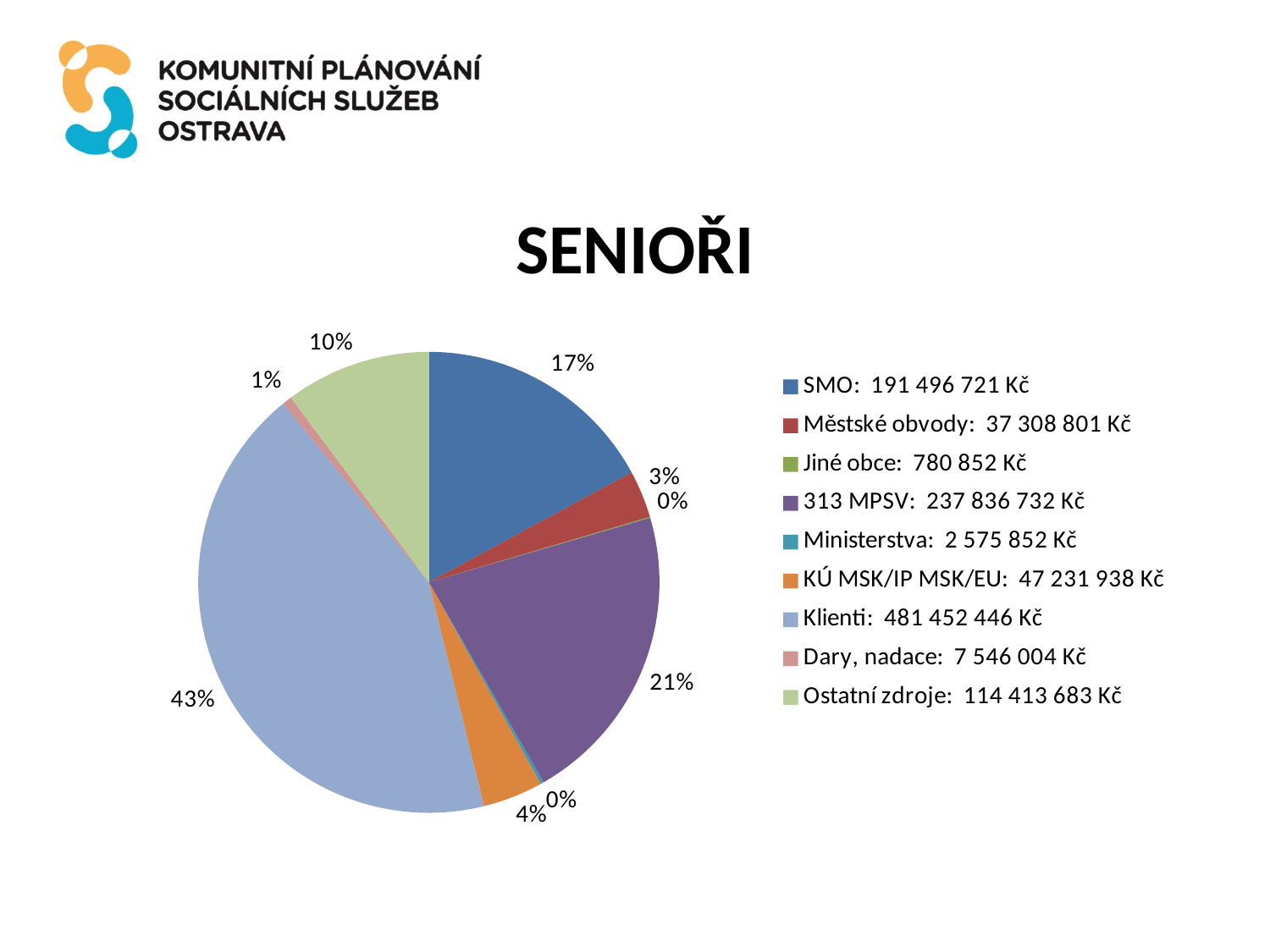
What kind of chart is shown on the slide? pie chart What share of the pie does Ostatní zdroje represent? 10% What is the value for Klienti shown in the legend? 481 452 446 Kč What is the value for Dary, nadace shown in the legend? 7 546 004 Kč Which category has the smallest value? Jiné obce What share of the pie does Klienti represent? 43% What is the difference between the values for 313 MPSV and SMO? 46 340 011 Kč Which is larger, SMO or 313 MPSV? 313 MPSV What is the title of the chart? SENIOŘI What is the value for 313 MPSV shown in the legend? 237 836 732 Kč How many categories does the pie chart have? 9 Which category has the largest share of the pie? Klienti